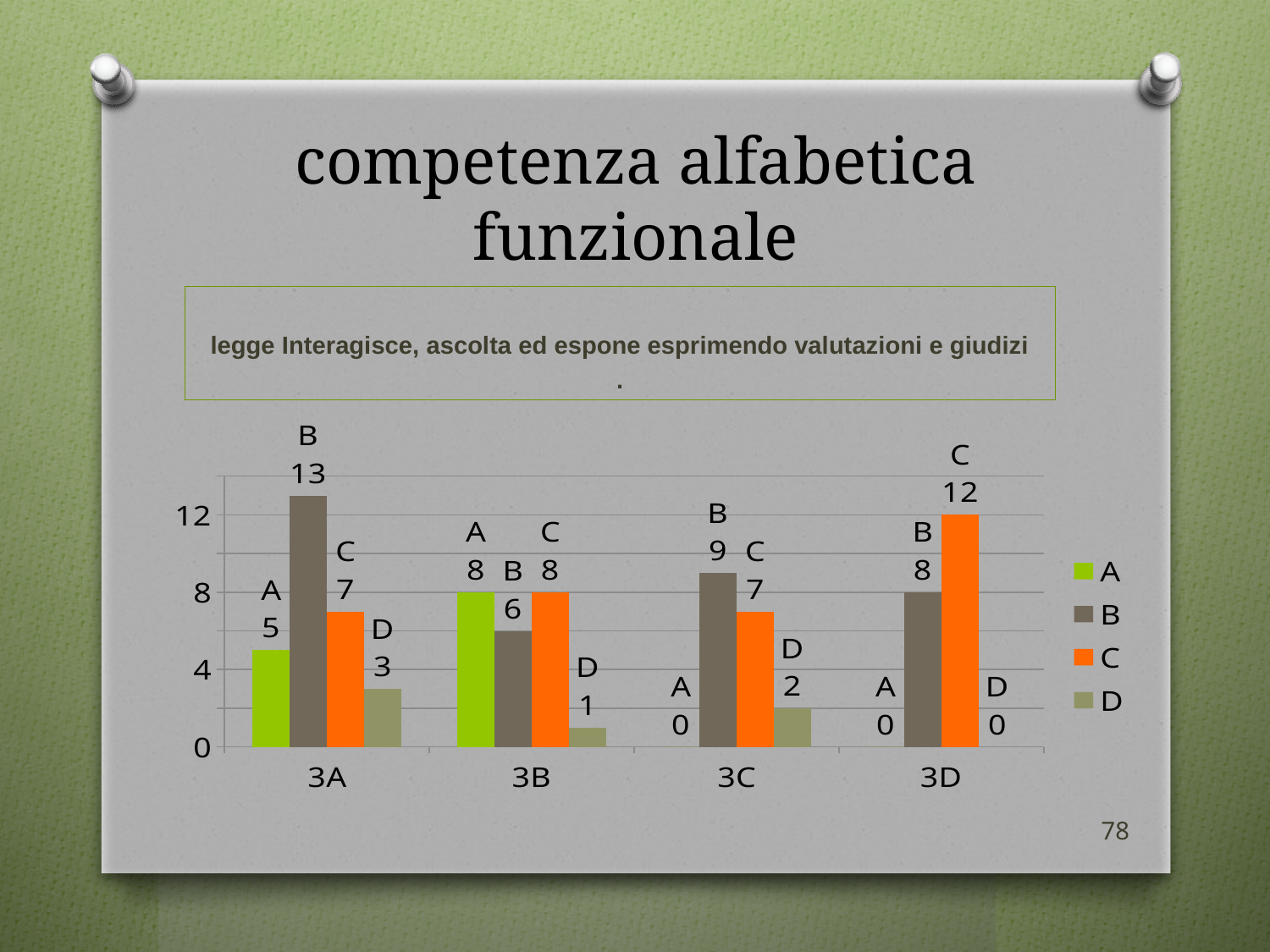
What is the value of series B for category 3A? 13 What is the value of series C for category 3D? 12 Which category has the highest value for series B? 3A What type of chart is shown on the slide? bar chart Which is larger for category 3B: series A or series B? A How many series does the legend list? 4 Which category has the lowest value for series C? 3A and 3C (both 7) How many categories are shown on the x axis? 4 What is the difference between series B and series C for category 3A? 6 What is the value of series A for category 3C? 0 What is the total of all four series for category 3B? 23 What is the value of series D for category 3B? 1